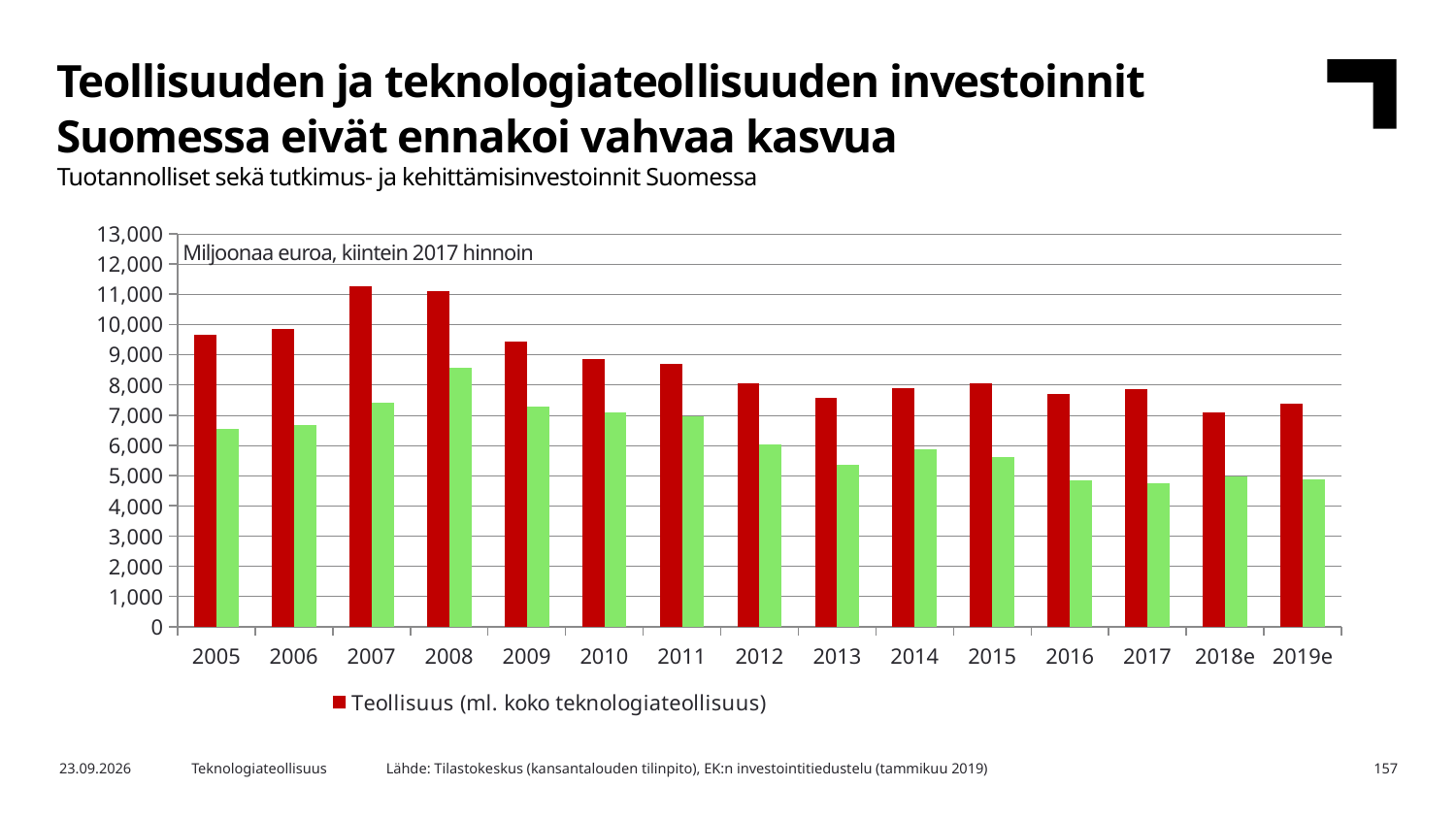
Is the value of the red bar for 2007 greater or less than 11,000? greater Do the red bars generally rise or fall from 2008 to 2019e? fall In which year is the red bar (Teollisuus) lowest? 2018e In which year is the green bar highest? 2008 How many years (categories) are shown on the x axis? 15 What unit is stated in the text box inside the chart? Miljoonaa euroa, kiintein 2017 hinnoin How many series does the legend list? 1 What kind of chart is shown on the slide? Bar chart Is the value of the green bar for 2017 greater or less than 5,000? less Is the value of the green bar for 2008 greater or less than 8,000? greater Which is larger, the red bar for 2009 or the red bar for 2010? 2009